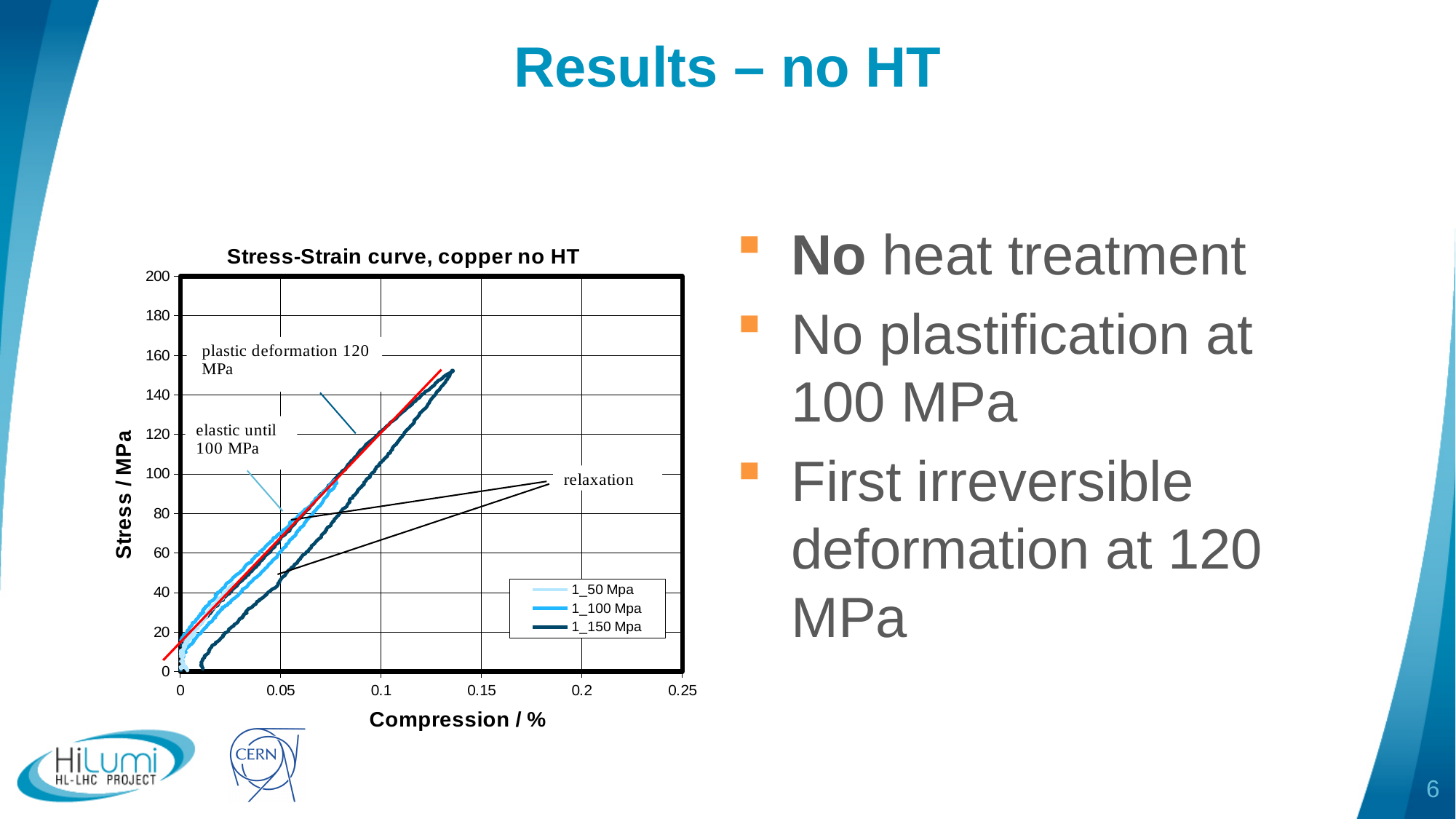
Is the maximum compression reached by the 1_150 Mpa series greater or less than 0.1? greater Is the peak stress reached by the 1_150 Mpa series greater or less than 160? less Which series reaches the highest stress in the chart? 1_150 Mpa Is the maximum compression reached by the 1_150 Mpa series greater or less than 0.15? less How many series does the legend of the chart list? 3 What are the names of the three series in the chart legend? 1_50 Mpa, 1_100 Mpa, 1_150 Mpa What is the title of the chart? Stress-Strain curve, copper no HT Along the loading part of the curves, does stress rise or fall as compression increases? rise What kind of chart is shown on the slide? line chart Which series reaches a higher stress, 1_100 Mpa or 1_150 Mpa? 1_150 Mpa